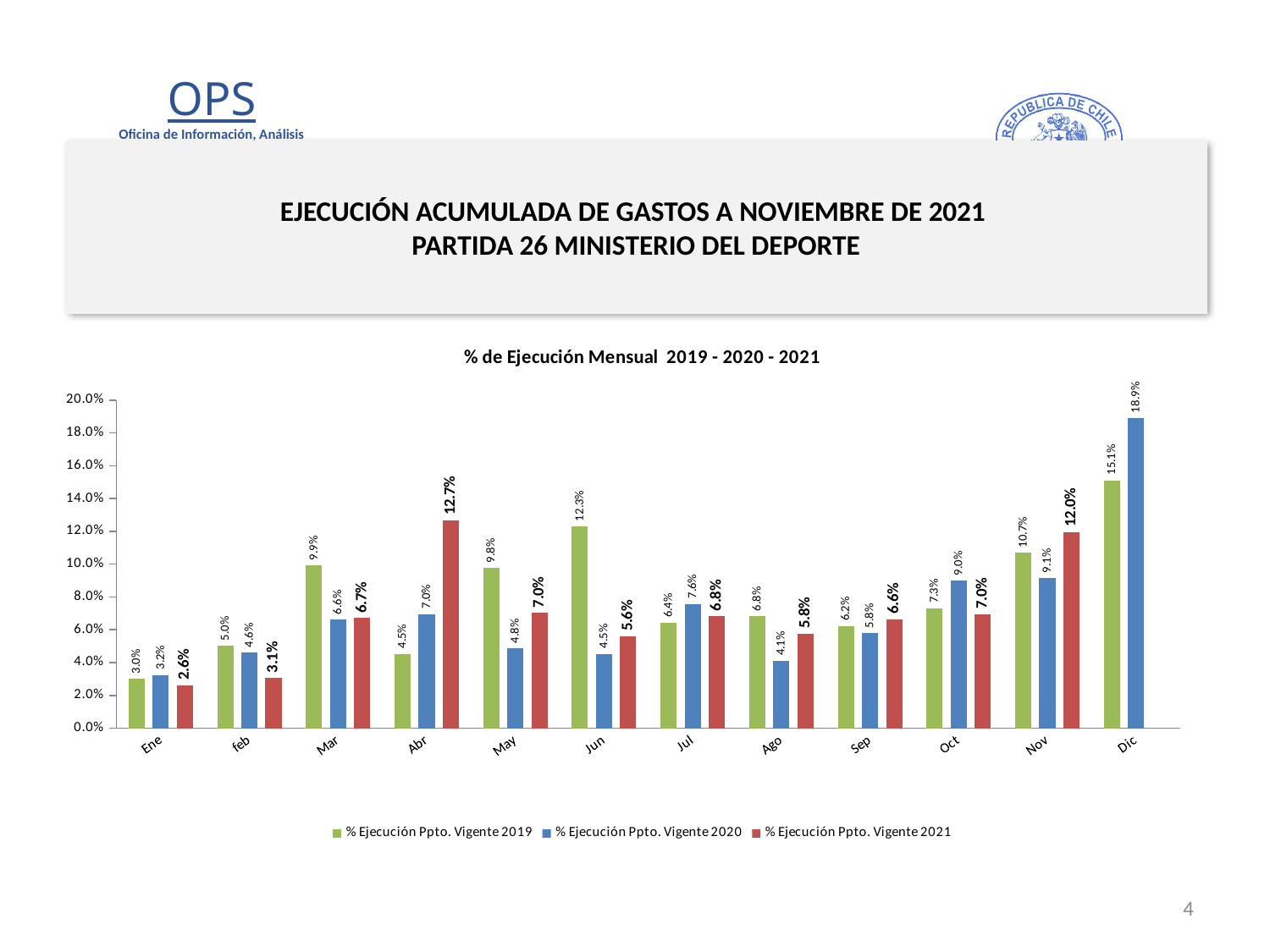
Which month has the highest value for % Ejecución Ppto. Vigente 2021? Abr How many series does the legend list? 3 How many months are shown on the x axis? 12 What kind of chart is shown? bar chart What is the value for % Ejecución Ppto. Vigente 2019 in Jun? 12.3% What is the value for % Ejecución Ppto. Vigente 2021 in Abr? 12.7% Is the value for % Ejecución Ppto. Vigente 2019 in Mar greater or less than 8.0%? greater In Nov, which series has the larger value: % Ejecución Ppto. Vigente 2019 or % Ejecución Ppto. Vigente 2021? % Ejecución Ppto. Vigente 2021 What is the value for % Ejecución Ppto. Vigente 2020 in Dic? 18.9% Which month has the lowest value for % Ejecución Ppto. Vigente 2019? Ene What is the title of the chart? % de Ejecución Mensual 2019 - 2020 - 2021 What is the difference between the 2020 and 2019 values in Dic? 3.8%